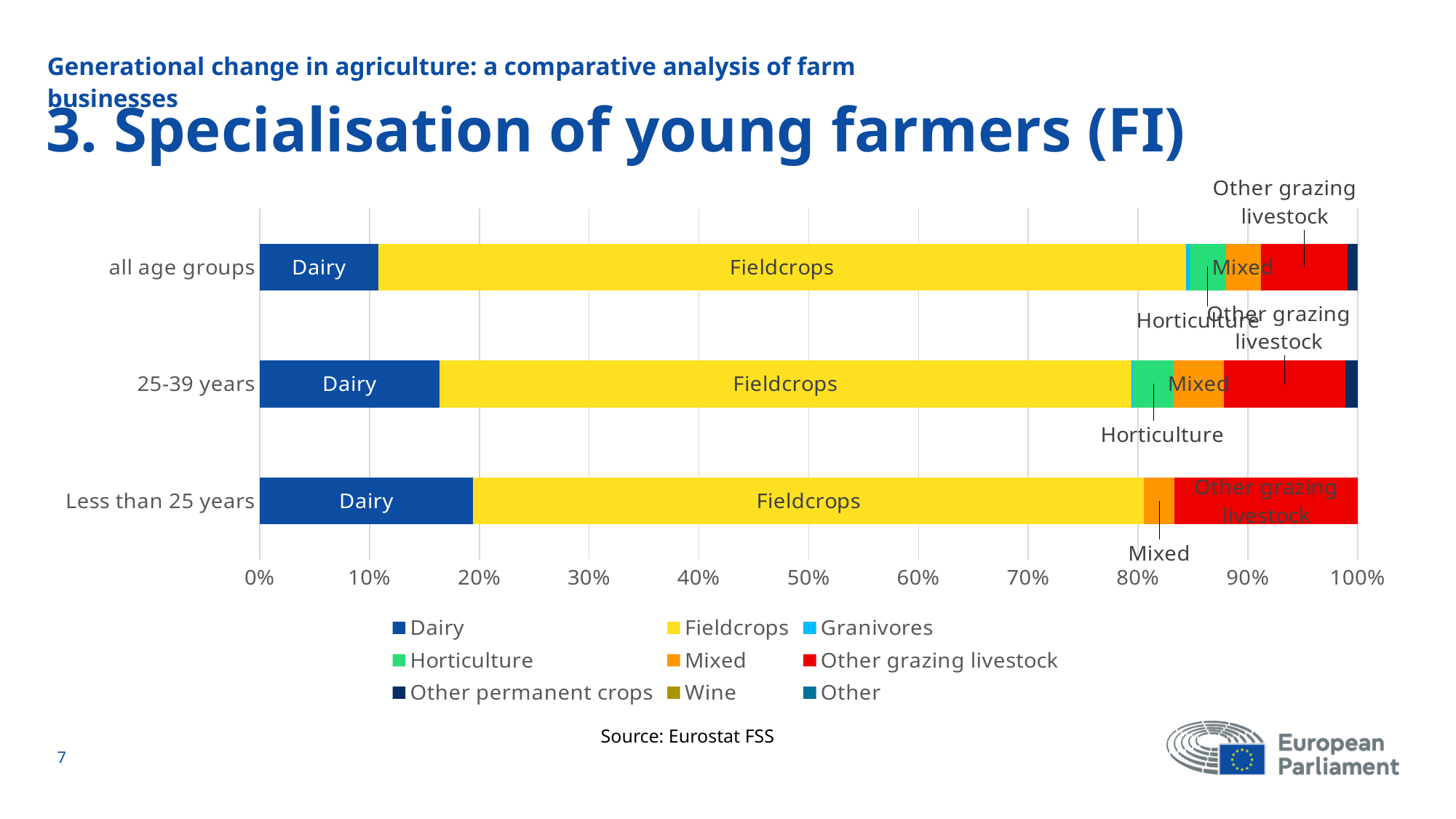
Is the Dairy share for Less than 25 years greater or less than 10%? greater How many series does the legend list? 9 Which is larger: the Other grazing livestock share for Less than 25 years or for all age groups? Less than 25 years How many age-group categories are plotted on the chart? 3 What is the source cited below the chart? Eurostat FSS Which is larger: the Dairy share for 25-39 years or for all age groups? 25-39 years Is the Fieldcrops share for all age groups greater or less than 60%? greater Is the Dairy share for all age groups greater or less than 20%? less Which age group has the largest Dairy share? Less than 25 years Which age group has the largest Fieldcrops share? all age groups Which age group has the smallest Dairy share? all age groups What kind of chart is shown on the slide? Stacked bar chart